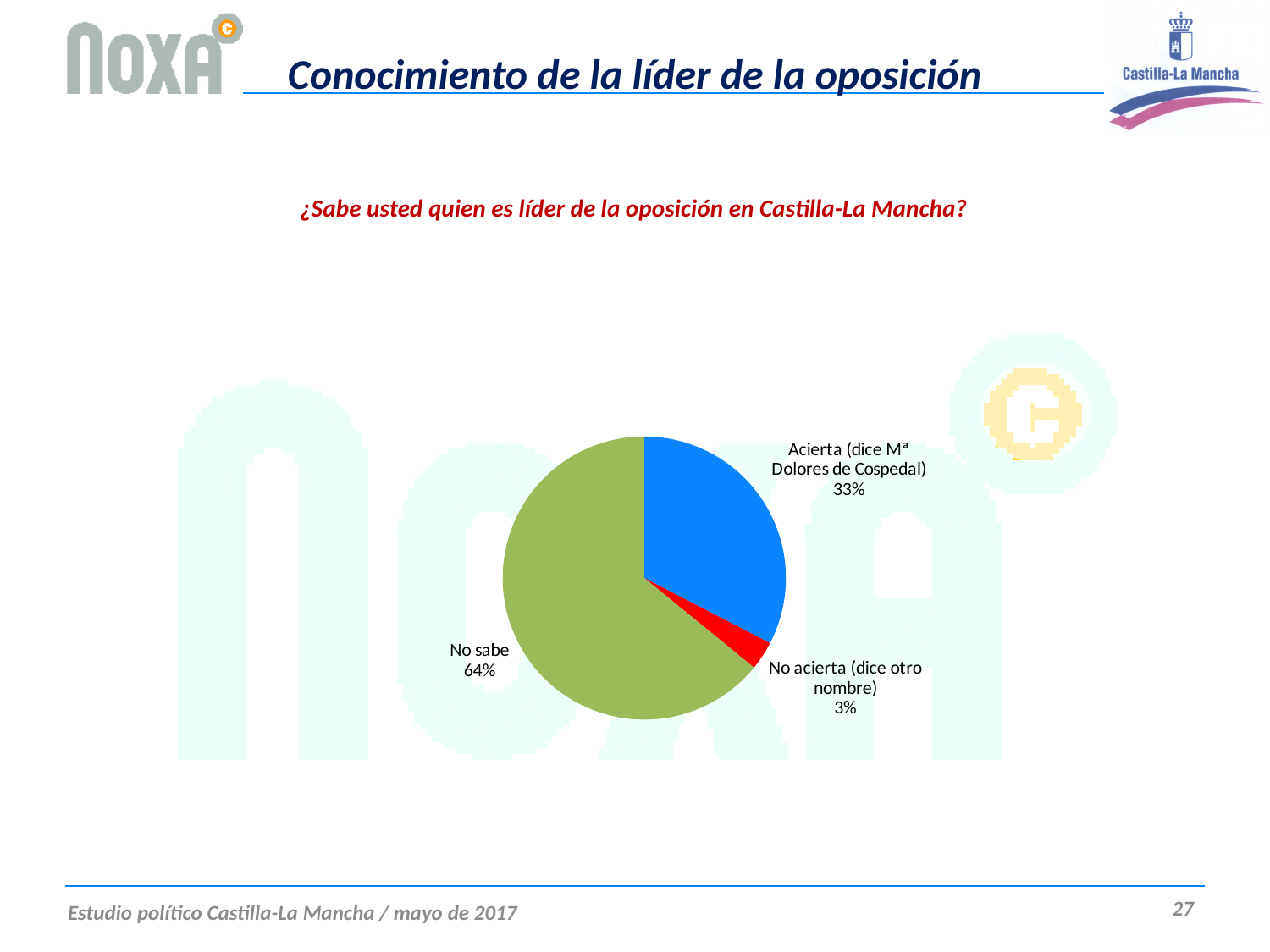
What percentage of respondents answered "Acierta (dice Mª Dolores de Cospedal)"? 33% Which category has the largest share of the pie? No sabe What percentage of respondents answered "No sabe"? 64% Which is larger: the share for "Acierta (dice Mª Dolores de Cospedal)" or the share for "No acierta (dice otro nombre)"? Acierta (dice Mª Dolores de Cospedal) How many slices does the pie chart have? 3 What is the difference in percentage points between "Acierta (dice Mª Dolores de Cospedal)" and "No acierta (dice otro nombre)"? 30 What is the difference in percentage points between "No sabe" and "Acierta (dice Mª Dolores de Cospedal)"? 31 Which category has the smallest share of the pie? No acierta (dice otro nombre) What percentage of respondents answered "No acierta (dice otro nombre)"? 3% What kind of chart is shown on the slide? pie chart What question is the pie chart answering, as written above the chart? ¿Sabe usted quien es líder de la oposición en Castilla-La Mancha? What colour is the "No sabe" slice of the pie? green